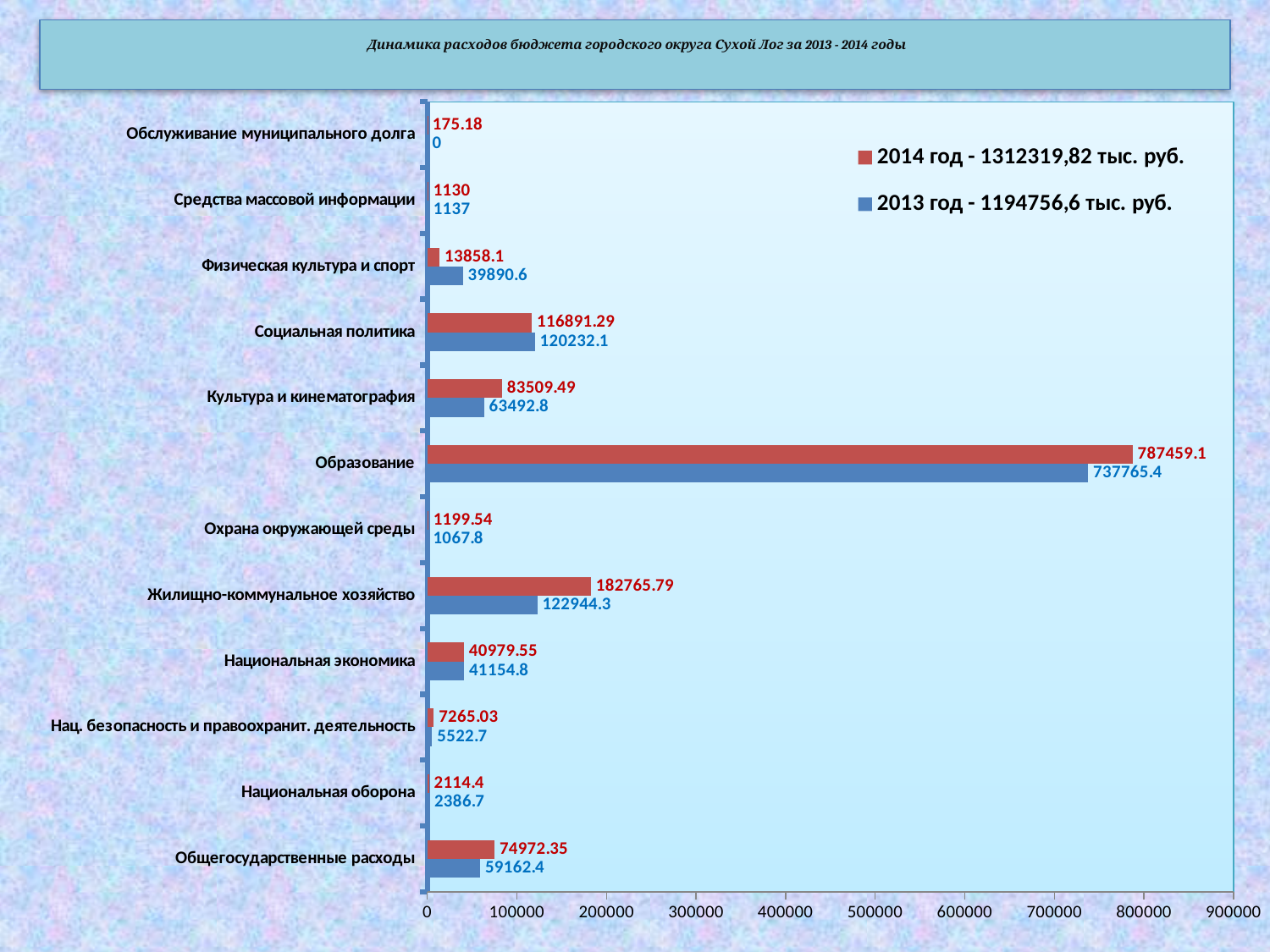
Which category has the highest 2014 value? Образование How many categories are shown on the chart? 12 Which category has the lowest 2013 value? Обслуживание муниципального долга What is the difference between the 2014 and 2013 values for Жилищно-коммунальное хозяйство? 59821.49 What is the 2014 value for Образование? 787459.1 How many series does the legend list? 2 What is the difference between the 2014 and 2013 values for Образование? 49693.7 What kind of chart is shown on the slide? Bar chart What is the 2014 value for Социальная политика? 116891.29 What is the 2013 value for Физическая культура и спорт? 39890.6 For Физическая культура и спорт, which year has the larger value, 2013 or 2014? 2013 What is the 2013 value for Жилищно-коммунальное хозяйство? 122944.3